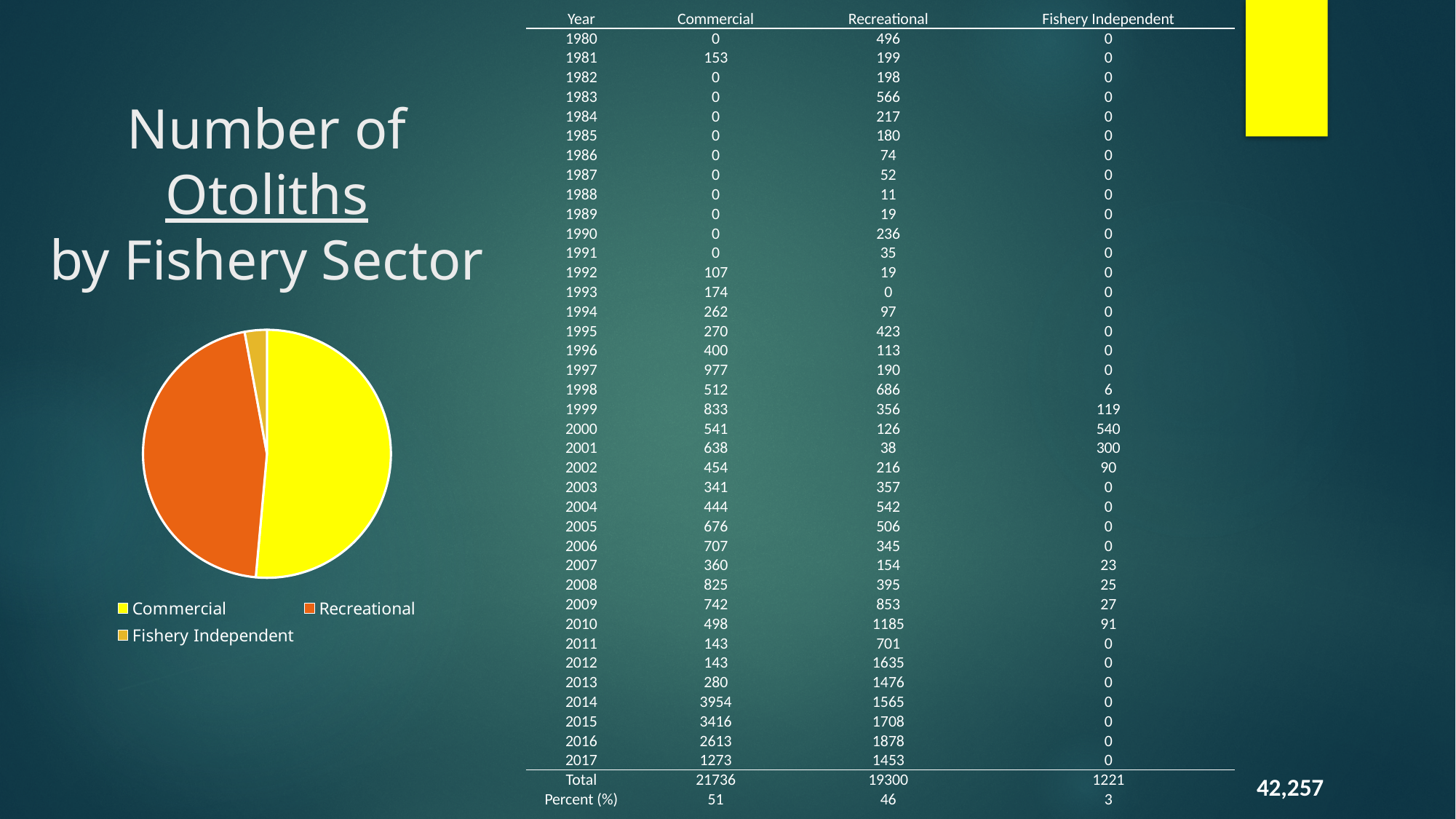
Which sector has the smallest slice in the pie chart? Fishery Independent What colour is the Recreational slice in the pie chart? orange According to the Percent (%) row of the table, what share of otoliths does the Commercial slice represent? 51 How many entries does the pie chart's legend list? 3 In the pie chart, which slice is larger: Recreational or Fishery Independent? Recreational According to the Percent (%) row of the table, what share of otoliths does the Fishery Independent slice represent? 3 Which sector has the largest slice in the pie chart? Commercial What is the total number of otoliths shown in the Total row for the Commercial sector? 21736 In the pie chart, which slice is larger: Commercial or Recreational? Commercial How many slices does the pie chart have? 3 What colour is the Commercial slice in the pie chart? yellow What kind of chart is shown on the left of the slide? pie chart